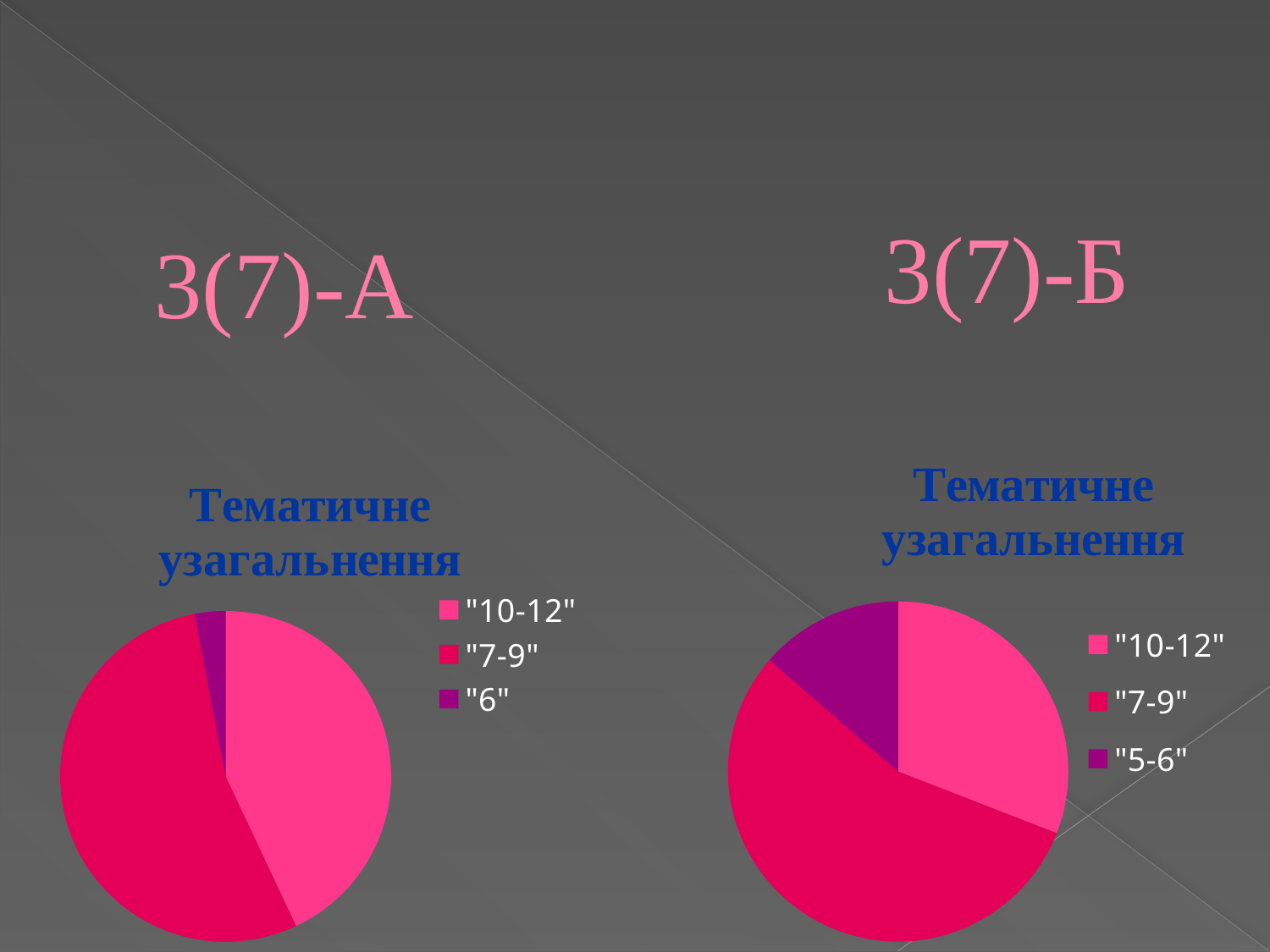
In the pie chart under 3(7)-А, which slice is larger, "7-9" or "6"? "7-9" In the pie chart under 3(7)-Б, what is the label of the third legend entry? "5-6" In the pie chart under 3(7)-А, which category has the smallest slice? "6" In the pie chart under 3(7)-Б, which category has the smallest slice? "5-6" In the pie chart under 3(7)-Б, which slice is larger, "10-12" or "5-6"? "10-12" In the pie chart under 3(7)-Б, which category has the largest slice? "7-9" What kind of chart is shown under the heading 3(7)-Б? pie chart In the pie chart under 3(7)-Б, how many slices does the pie have? 3 In the pie chart under 3(7)-А, how many slices does the pie have? 3 In the pie chart under 3(7)-А, how many entries does the legend list? 3 What is the title of the pie chart under 3(7)-Б? Тематичне узагальнення What kind of chart is shown under the heading 3(7)-А? pie chart